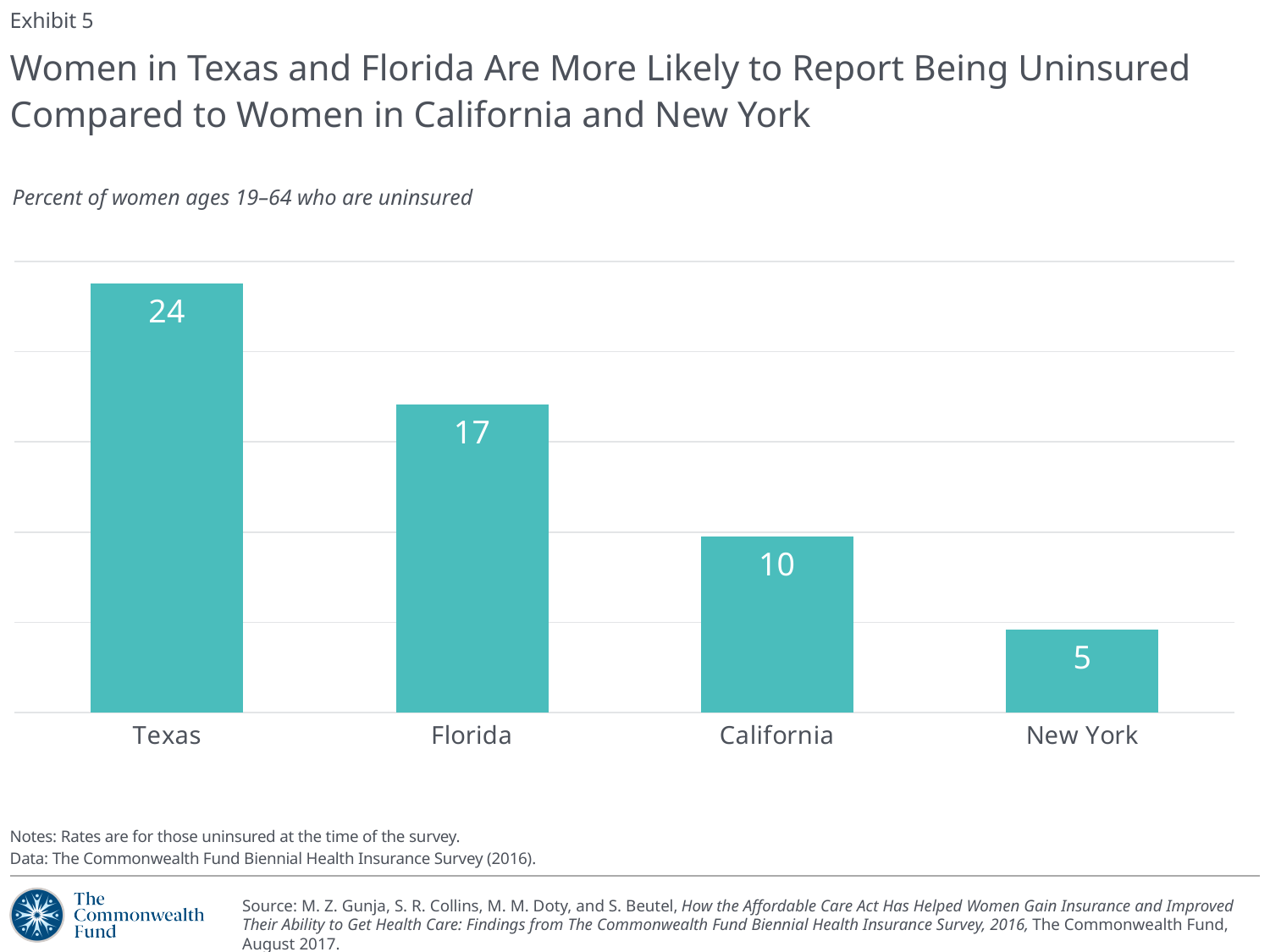
What is the percent of uninsured women ages 19–64 in Florida? 17 Which state has the lowest percent of uninsured women? New York Do the values rise or fall moving from Texas to New York along the x axis? Fall What is the percent of uninsured women ages 19–64 in California? 10 What kind of chart is shown on the slide? Bar chart What is the percent of uninsured women ages 19–64 in New York? 5 Which state has a higher uninsured rate, Florida or California? Florida What is the difference between the uninsured rates for Florida and California? 7 How many states are shown in the chart? 4 What is the difference between the uninsured rates for Texas and New York? 19 What is the percent of uninsured women ages 19–64 in Texas? 24 Which state has the highest percent of uninsured women? Texas